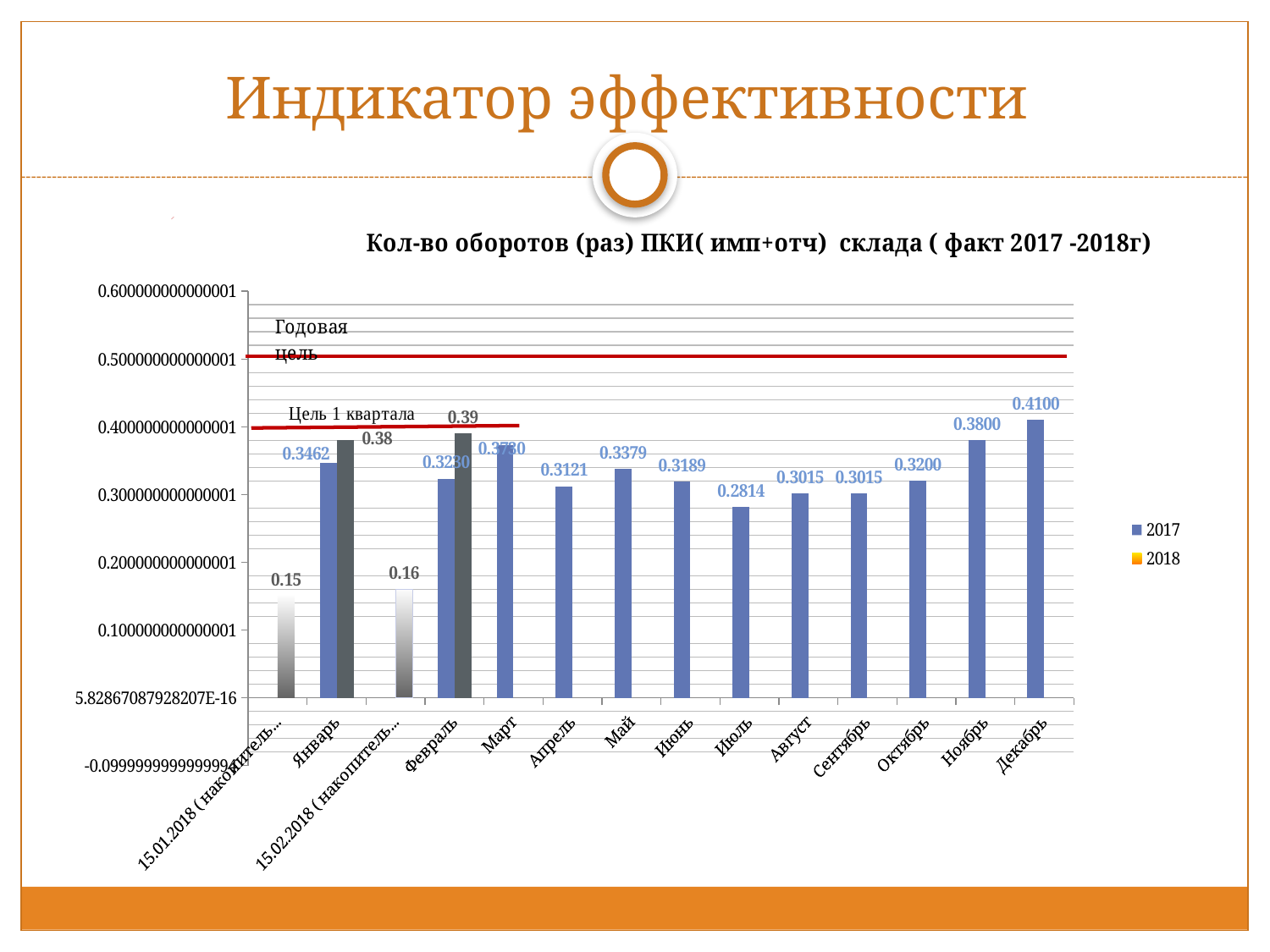
What is the 2017 value for Декабрь? 0.4100 What is the 2017 value for Июль? 0.2814 Which month has the highest 2017 value? Декабрь What is the value shown for 15.01.2018 (накопитель...)? 0.15 How many series does the legend list? 2 Is the 2017 value for Июль greater or less than 0.3? less Which is larger, the 2017 value for Май or for Апрель? Май How many categories are shown on the x axis? 14 What is the difference between the 2017 values for Декабрь and Ноябрь? 0.0300 What is the 2018 value for Февраль? 0.39 What kind of chart is shown on the slide? bar chart Which month has the lowest 2017 value? Июль